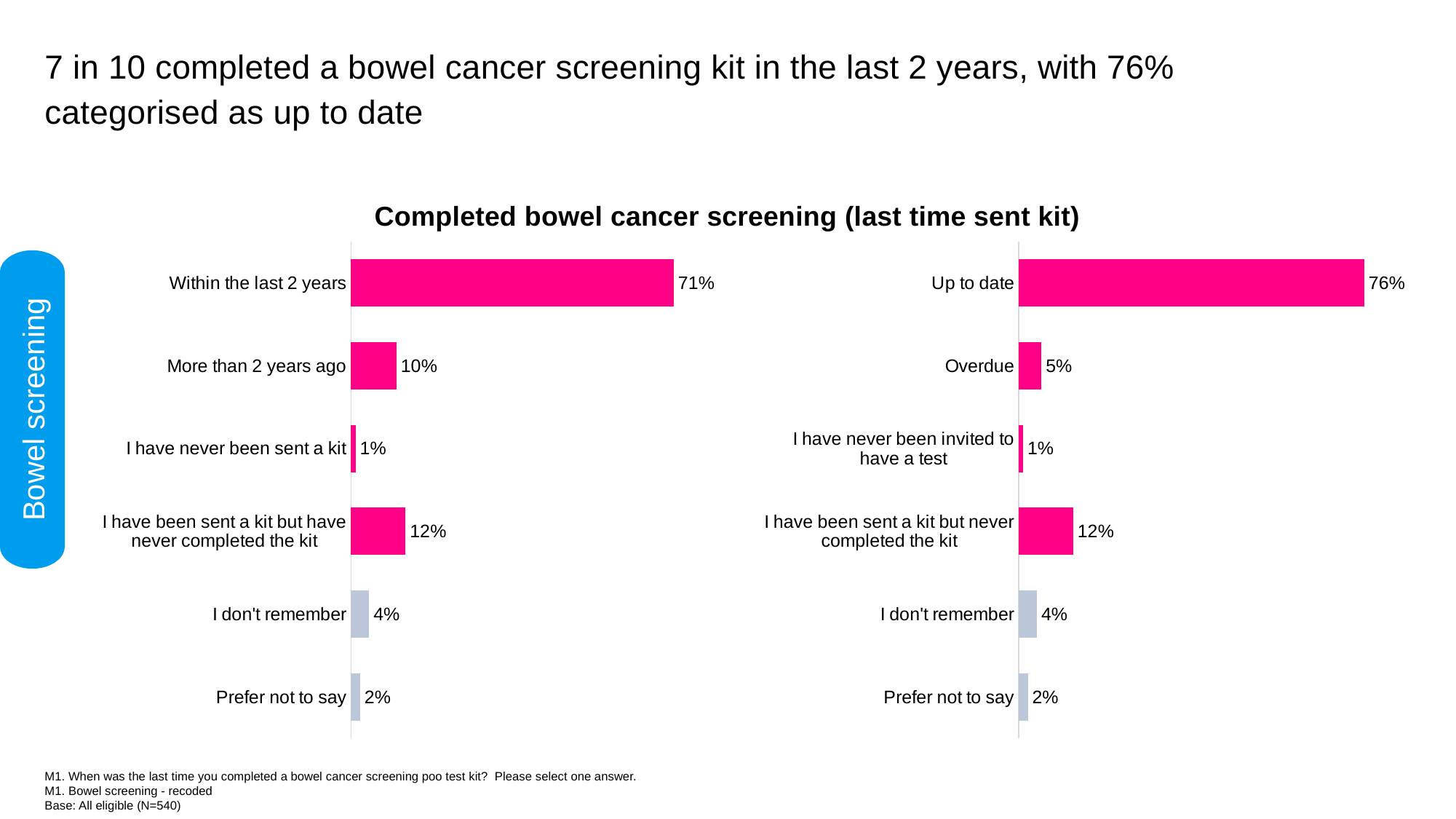
In the right chart, which category has the lowest value? I have never been invited to have a test In the right chart, what is the value for 'Overdue'? 5% In the right chart, what is the value for 'Up to date'? 76% In the left chart, which is larger: 'More than 2 years ago' or 'I have been sent a kit but have never completed the kit'? I have been sent a kit but have never completed the kit In the left chart, which category has the highest value? Within the last 2 years What type of chart is the left chart? Bar chart In the left chart, what is the value for 'Within the last 2 years'? 71% What is the title shown above the charts? Completed bowel cancer screening (last time sent kit) In the left chart, what is the value for 'More than 2 years ago'? 10% How many categories are shown in the right chart? 6 In the right chart, what is the difference between 'Up to date' and 'Overdue'? 71% In the left chart, what is the difference between 'Within the last 2 years' and 'More than 2 years ago'? 61%